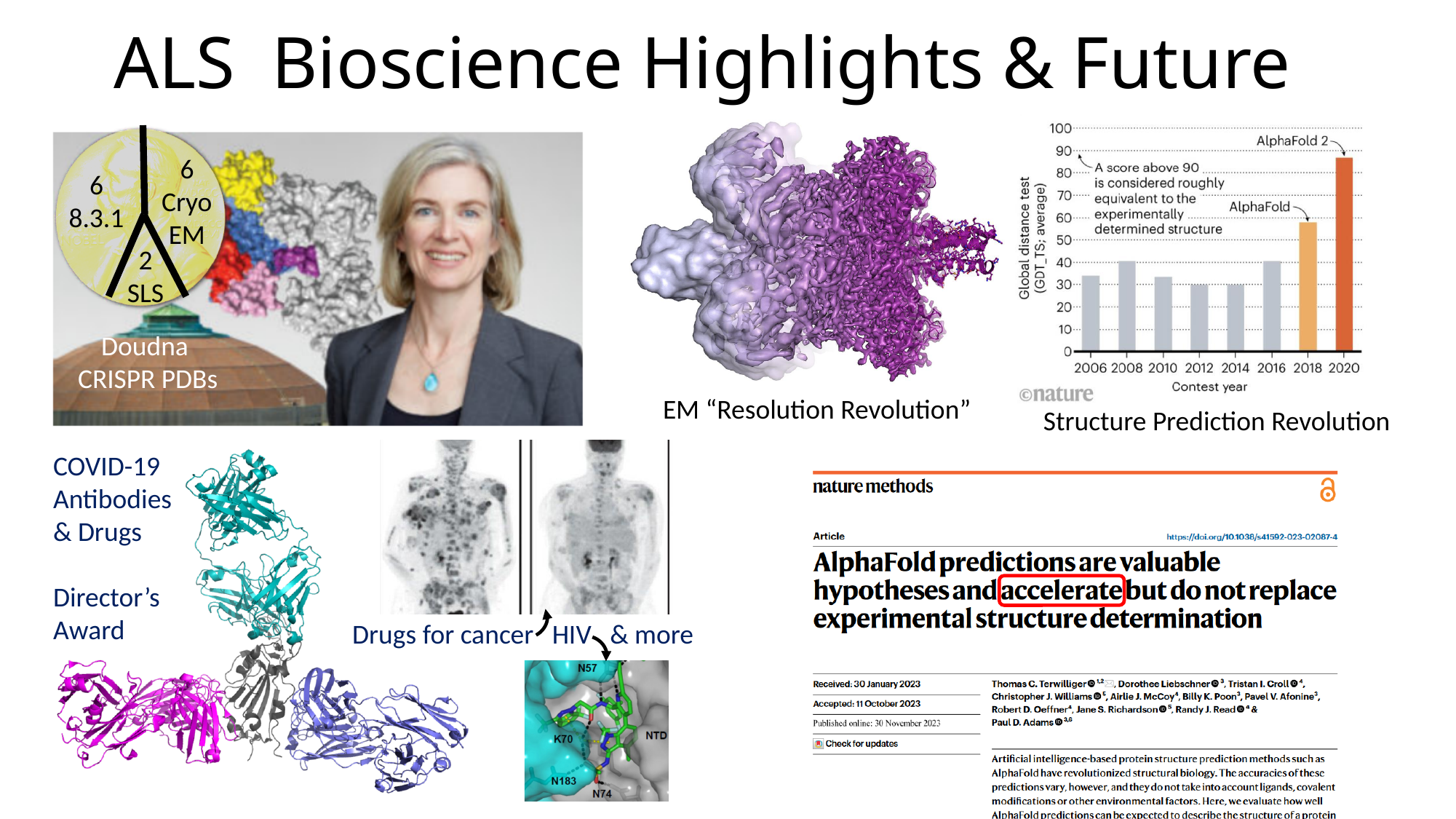
In the 'Structure Prediction Revolution' bar chart, is the value for 2008 greater or less than 50? less In the 'Structure Prediction Revolution' bar chart, is the value for 2018 greater or less than 50? greater In the 'Structure Prediction Revolution' bar chart, do the values rise or fall from 2016 to 2020? rise In the 'Structure Prediction Revolution' bar chart, how many contest years are shown on the x axis? 8 In the 'Structure Prediction Revolution' bar chart, is the value for 2012 greater or less than 40? less In the 'Structure Prediction Revolution' bar chart, which is larger, the value for 2018 or the value for 2016? 2018 In the circular 'Doudna CRISPR PDBs' diagram at the top left, what number is shown for SLS? 2 What kind of chart is the 'Structure Prediction Revolution' chart? bar chart In the 'Structure Prediction Revolution' bar chart, what is the x-axis title? Contest year In the 'Structure Prediction Revolution' bar chart, which contest year has the highest bar? 2020 In the 'Structure Prediction Revolution' bar chart, which contest year is labelled 'AlphaFold 2'? 2020